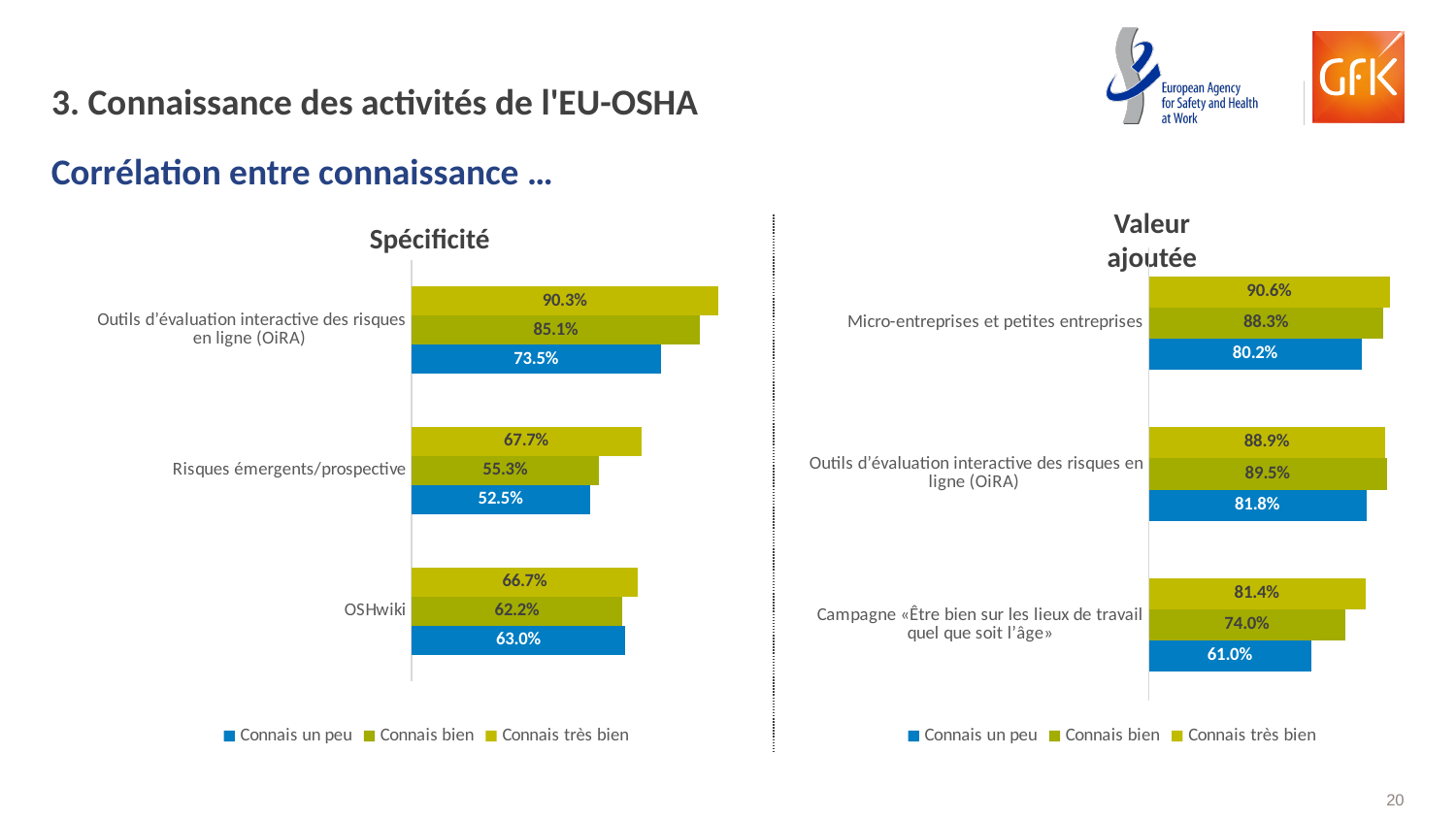
How many series does the legend of the 'Spécificité' chart list? 3 In the 'Valeur ajoutée' chart, what is the 'Connais un peu' value for Campagne «Être bien sur les lieux de travail quel que soit l'âge»? 61.0% In the 'Spécificité' chart, what is the 'Connais un peu' value for Risques émergents/prospective? 52.5% In the 'Valeur ajoutée' chart, what is the 'Connais bien' value for Outils d'évaluation interactive des risques en ligne (OiRA)? 89.5% In the 'Spécificité' chart, what is the difference between the 'Connais très bien' and 'Connais un peu' values for Outils d'évaluation interactive des risques en ligne (OiRA)? 16.8% What type of chart is the 'Spécificité' chart? Bar chart In the 'Valeur ajoutée' chart, which category has the highest 'Connais très bien' value? Micro-entreprises et petites entreprises In the 'Valeur ajoutée' chart, which is larger for Campagne «Être bien sur les lieux de travail quel que soit l'âge»: 'Connais très bien' or 'Connais bien'? Connais très bien In the 'Spécificité' chart, which category has the lowest 'Connais un peu' value? Risques émergents/prospective In the 'Spécificité' chart, what is the 'Connais bien' value for OSHwiki? 62.2% In the 'Spécificité' chart, what is the 'Connais très bien' value for Outils d'évaluation interactive des risques en ligne (OiRA)? 90.3% How many categories are shown in the 'Valeur ajoutée' chart? 3